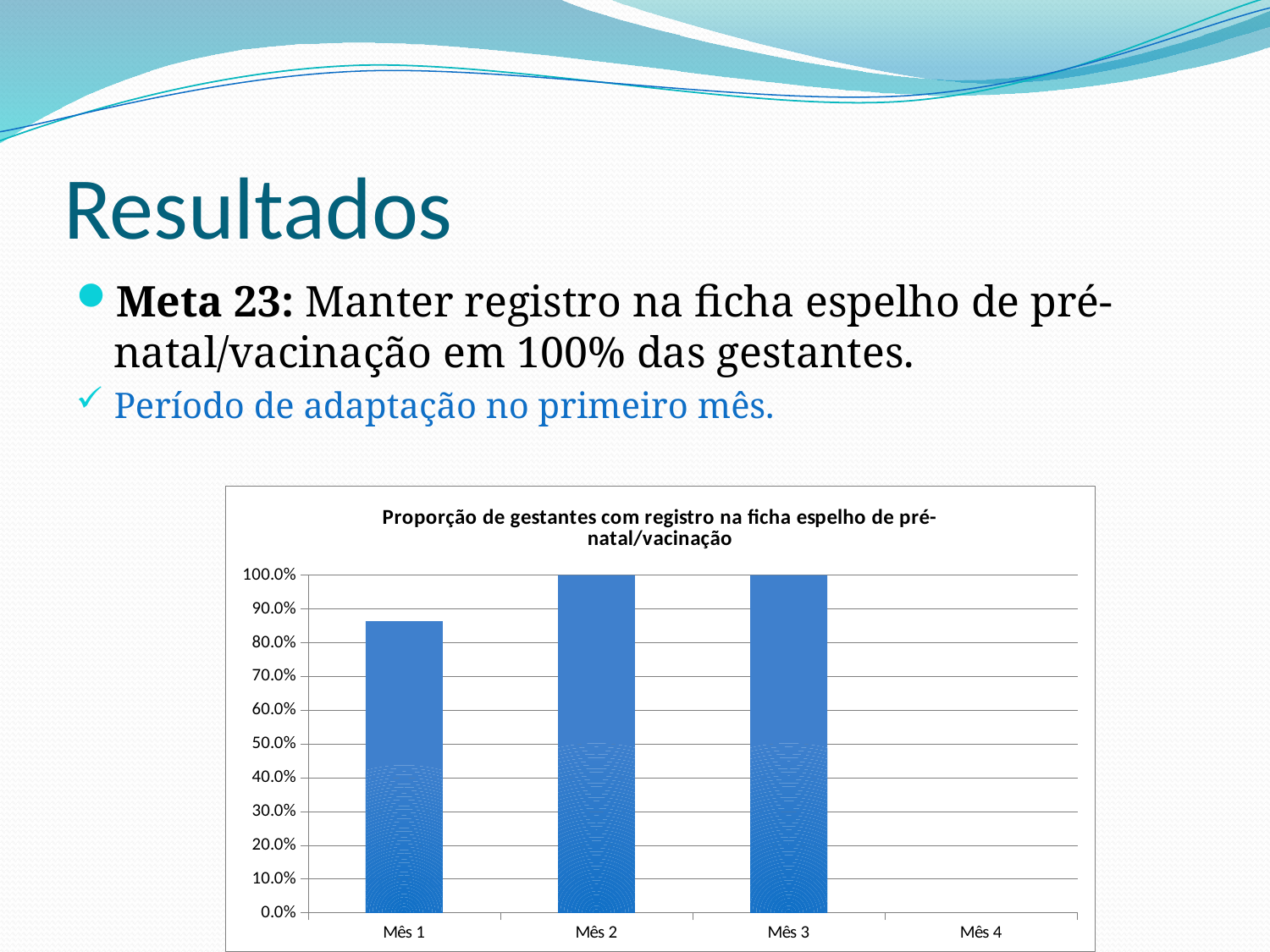
How many categories are shown on the x axis of the chart? 4 What is the title of the chart? Proporção de gestantes com registro na ficha espelho de pré-natal/vacinação Is the value for Mês 1 greater or less than 90.0%? less Among Mês 1, Mês 2 and Mês 3, which has the lowest value? Mês 1 Is the value for Mês 1 greater or less than 80.0%? greater What is the value for Mês 3? 100.0% Which is larger, the value for Mês 1 or the value for Mês 2? Mês 2 Does the value rise or fall from Mês 1 to Mês 2? rise What is the highest tick label on the y axis of the chart? 100.0% What is the value for Mês 2? 100.0% What kind of chart is shown on the slide? bar chart What is the difference between the values for Mês 2 and Mês 3? 0.0%